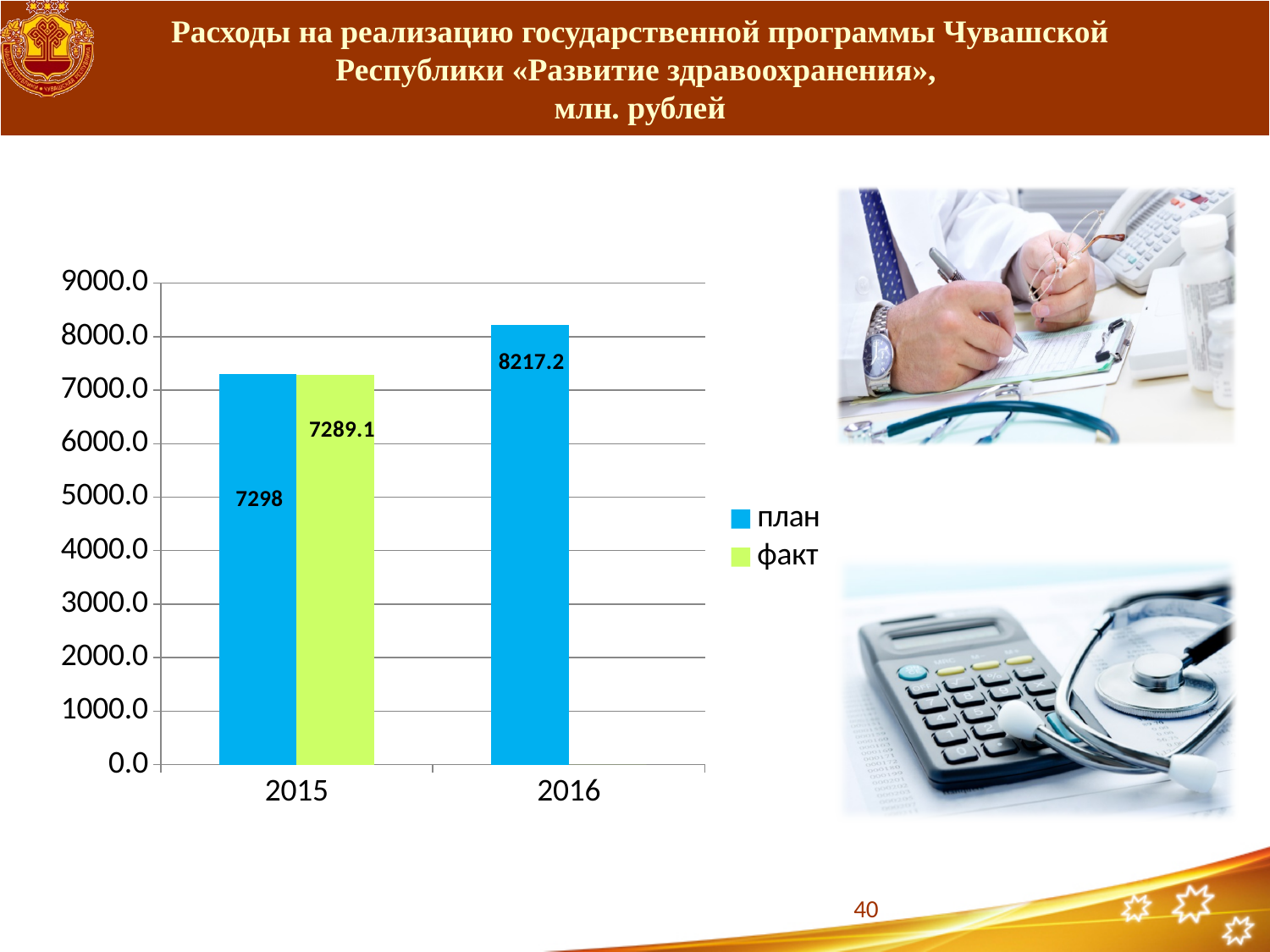
How many series does the legend list? 2 Which is larger: the план value for 2016 or the план value for 2015? план for 2016 What is the difference between the план values for 2016 and 2015? 919.2 What is the факт value for 2015? 7289.1 What is the difference between the план and факт values for 2015? 8.9 Which year has the highest план value? 2016 Is the план value for 2016 greater or less than 8000? greater How many years are shown on the x axis? 2 What is the план value for 2016? 8217.2 What is the план value for 2015? 7298 Which colour represents the факт series in the legend? green What kind of chart is shown on the slide? bar chart